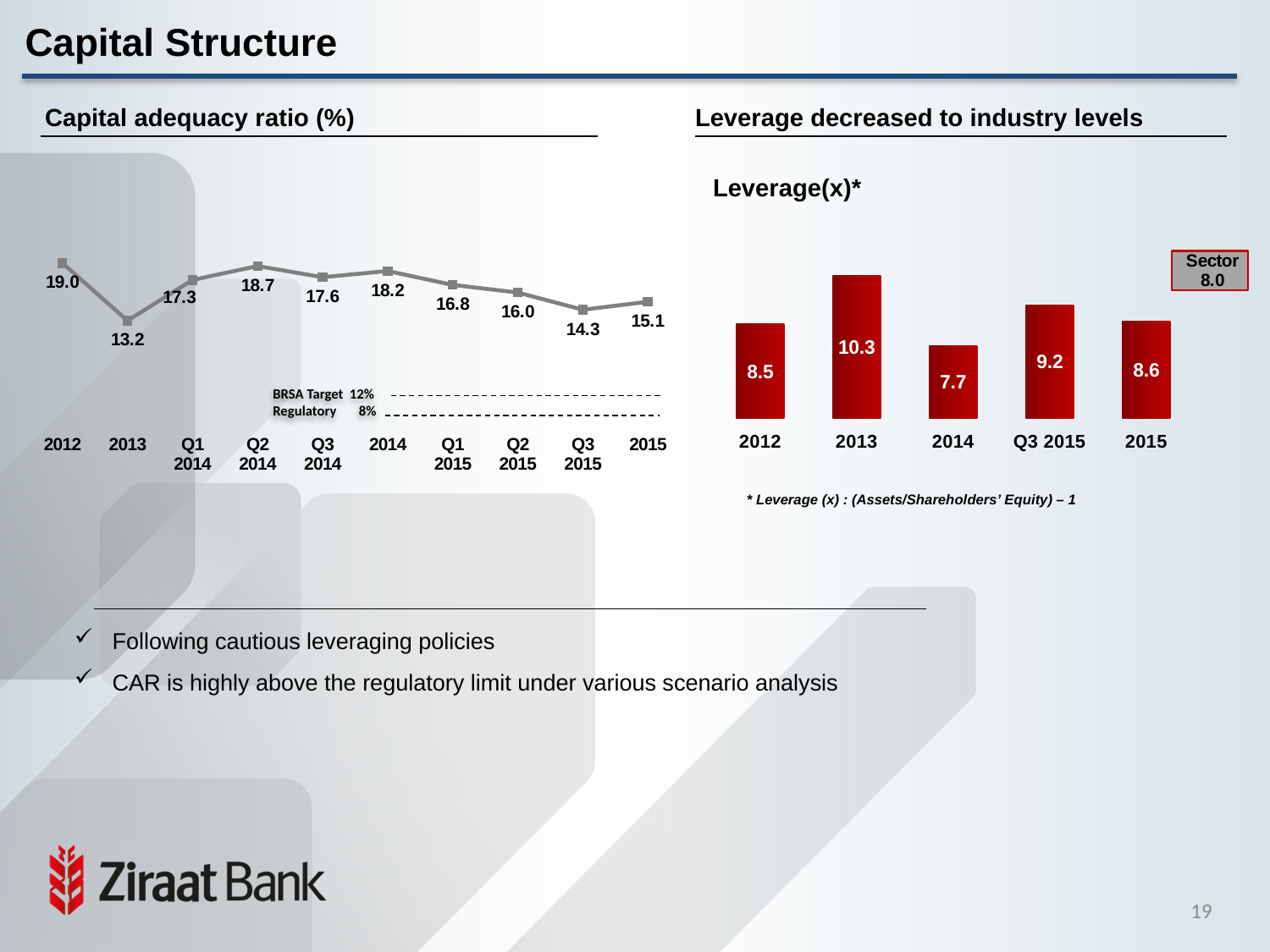
In the Capital adequacy ratio (%) chart, which period has the lowest value? 2013 In the Leverage(x) chart, is the value for Q3 2015 larger or smaller than the value for 2015? Larger In the Capital adequacy ratio (%) chart, how many data points are plotted? 10 What kind of chart is the Capital adequacy ratio (%) chart? Line chart In the Capital adequacy ratio (%) chart, what is the value for Q3 2015? 14.3 In the Capital adequacy ratio (%) chart, which period has the highest value? 2012 In the Capital adequacy ratio (%) chart, what is the difference between the 2012 value and the 2015 value? 3.9 In the Capital adequacy ratio (%) chart, what is the value for 2012? 19.0 In the Leverage(x) chart, which period has the lowest value? 2014 In the Leverage(x) chart, what is the difference between the 2013 value and the 2014 value? 2.6 In the Leverage(x) chart, what is the value for 2013? 10.3 What kind of chart is the Leverage(x) chart? Bar chart